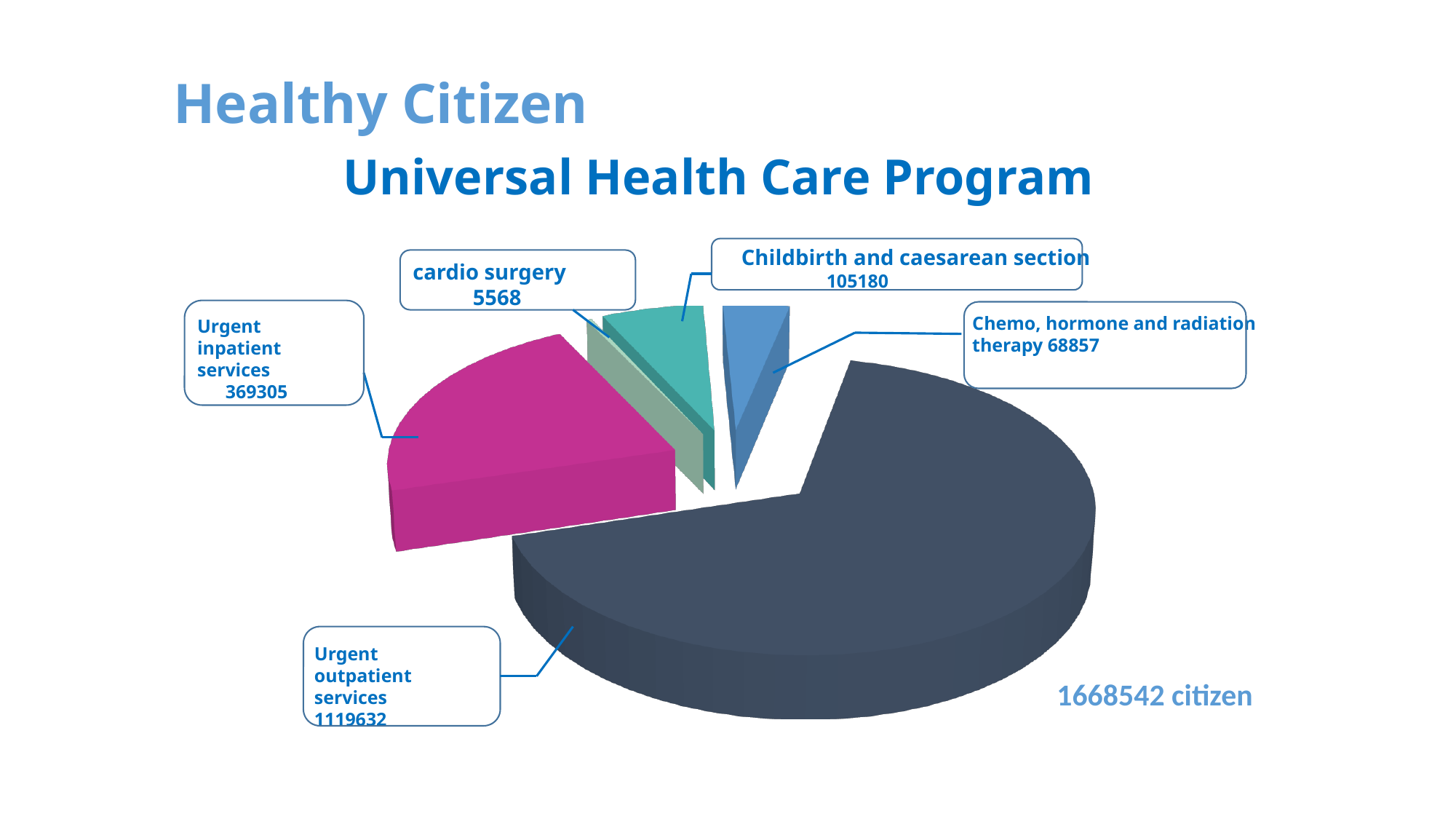
What is the value for Chemo, hormone and radiation therapy? 68857 What is the value for Urgent inpatient services? 369305 What is the value for Childbirth and caesarean section? 105180 What is the value for Urgent outpatient services? 1119632 Which category has the smallest slice of the pie? cardio surgery Which is larger: Childbirth and caesarean section or Chemo, hormone and radiation therapy? Childbirth and caesarean section Which category has the largest slice of the pie? Urgent outpatient services What total number of citizens is stated on the slide for the pie chart? 1668542 citizen What kind of chart is shown on the slide? Pie chart What is the value for cardio surgery? 5568 What is the difference between Urgent inpatient services and Childbirth and caesarean section? 264125 How many slices does the pie chart have? 5